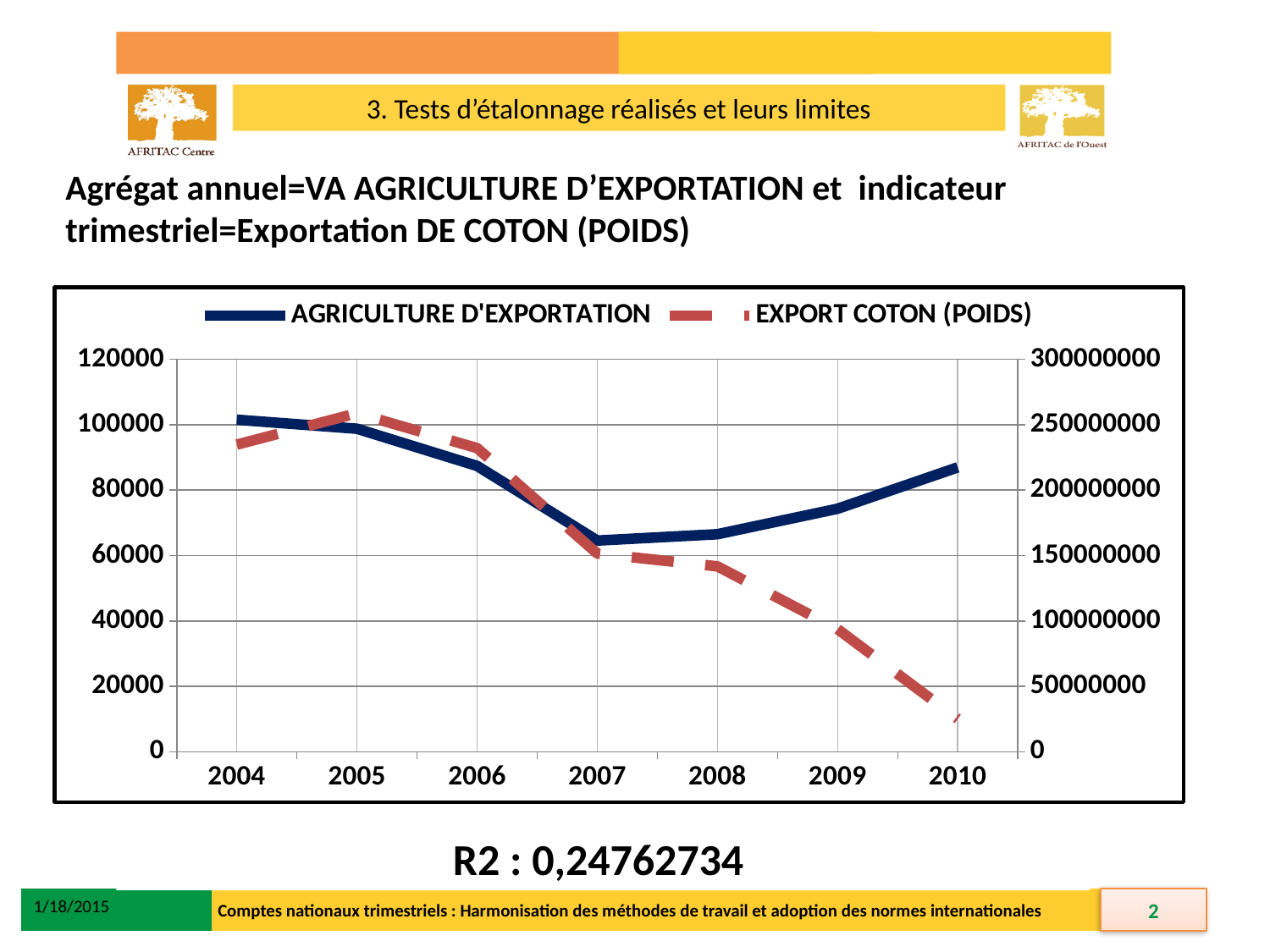
What kind of chart is shown on the slide? line chart Is the value for EXPORT COTON (POIDS) in 2005 greater or less than 200000000? greater In which year is EXPORT COTON (POIDS) at its highest? 2005 Does the EXPORT COTON (POIDS) series rise or fall between 2005 and 2010? fall Is the value for AGRICULTURE D'EXPORTATION in 2007 greater or less than 80000? less How many series does the chart legend list? 2 How many years are plotted along the x axis of the chart? 7 What is the highest tick value shown on the right-hand axis of the chart? 300000000 Is the value for EXPORT COTON (POIDS) in 2010 greater or less than 50000000? less In which year is EXPORT COTON (POIDS) at its lowest? 2010 Which is larger for AGRICULTURE D'EXPORTATION, the value in 2004 or the value in 2010? 2004